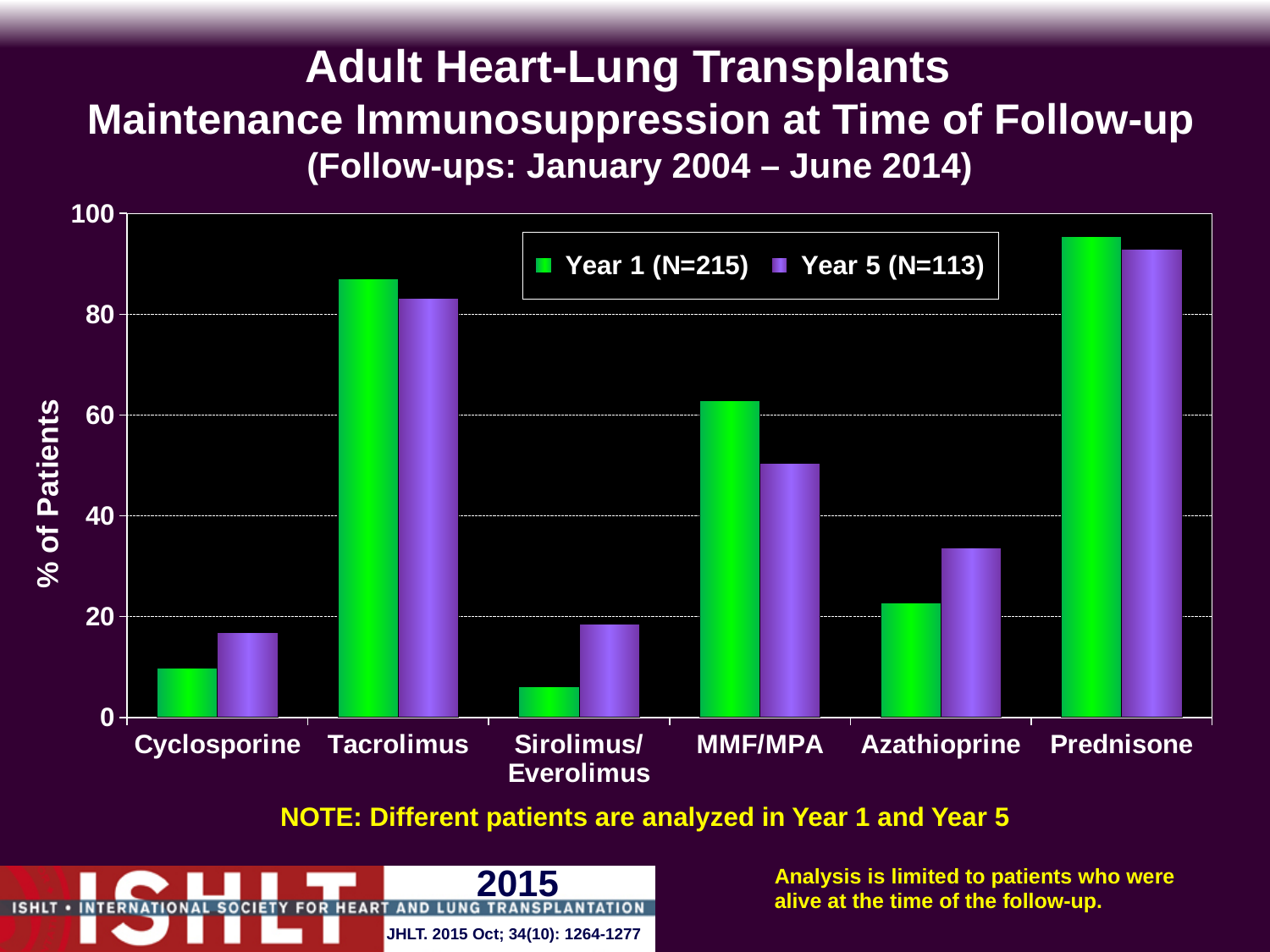
What is the label of the y axis? % of Patients For Azathioprine, which is larger: the Year 1 (N=215) value or the Year 5 (N=113) value? Year 5 (N=113) Is the Year 1 (N=215) value for Cyclosporine greater or less than 20? less Which drug has the highest Year 5 (N=113) percentage of patients? Prednisone Is the Year 5 (N=113) value for Azathioprine greater or less than 40? less Which drug has the lowest Year 1 (N=215) percentage of patients? Sirolimus/Everolimus Which drug has the highest Year 1 (N=215) percentage of patients? Prednisone How many series does the legend list? 2 Is the Year 1 (N=215) value for Tacrolimus greater or less than 80? greater How many drug categories are shown on the x axis? 6 For MMF/MPA, which is larger: the Year 1 (N=215) value or the Year 5 (N=113) value? Year 1 (N=215) What kind of chart is shown on the slide? bar chart